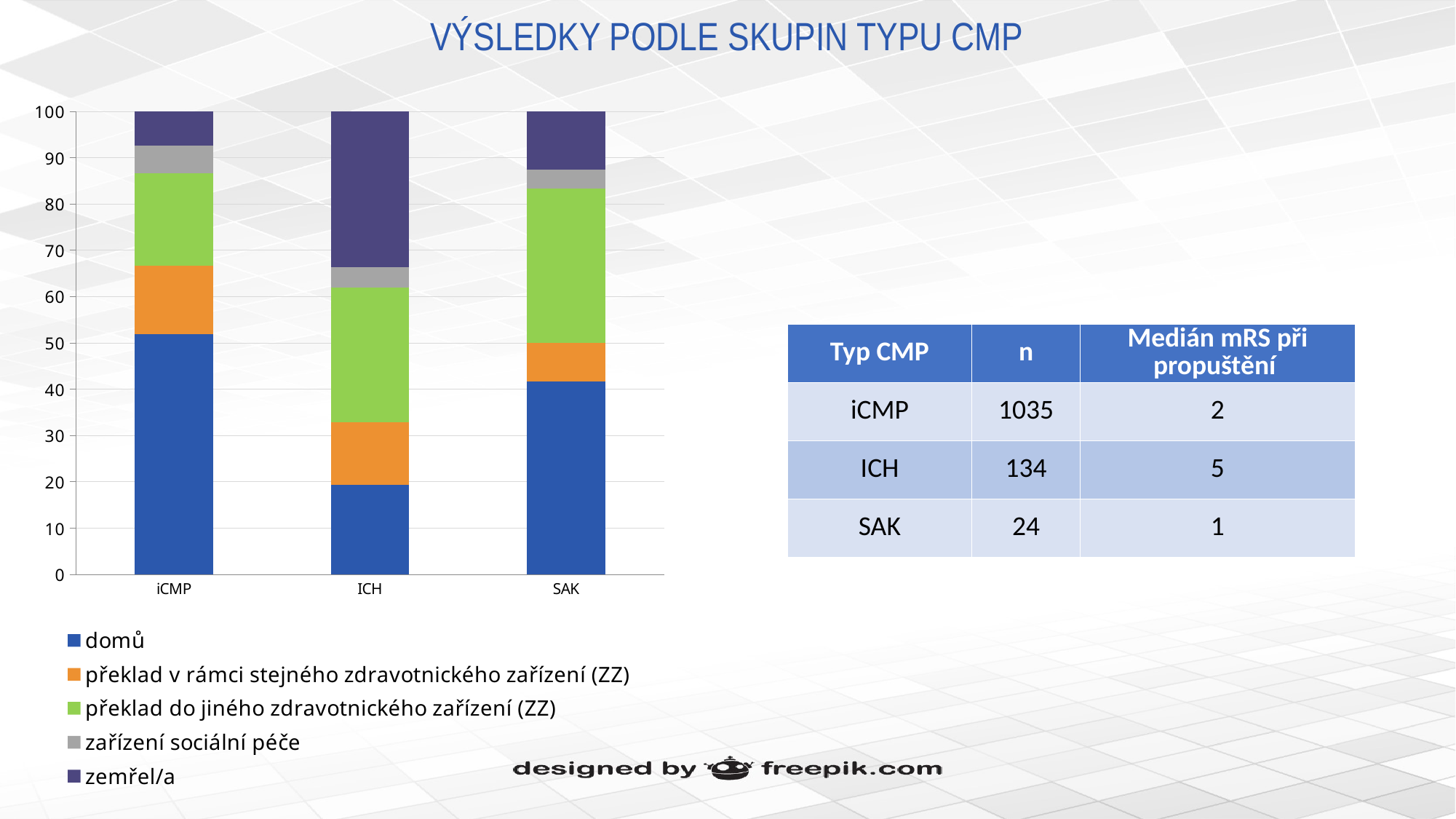
How many categories (types of CMP) are shown on the x axis of the chart? 3 Is the 'domů' share for SAK greater or less than 50? less Which has a larger 'zemřel/a' share, ICH or SAK? ICH Which category has the largest share for 'zemřel/a'? ICH What kind of chart is shown on the slide? stacked bar chart Which has a larger 'domů' share, iCMP or SAK? iCMP What value does each stacked bar total on the y axis? 100 Is the 'domů' share for ICH greater or less than 30? less Which category has the smallest share for 'domů'? ICH Which category has the largest share for 'domů'? iCMP What is the title of the slide containing the chart? VÝSLEDKY PODLE SKUPIN TYPU CMP How many series does the chart legend list? 5